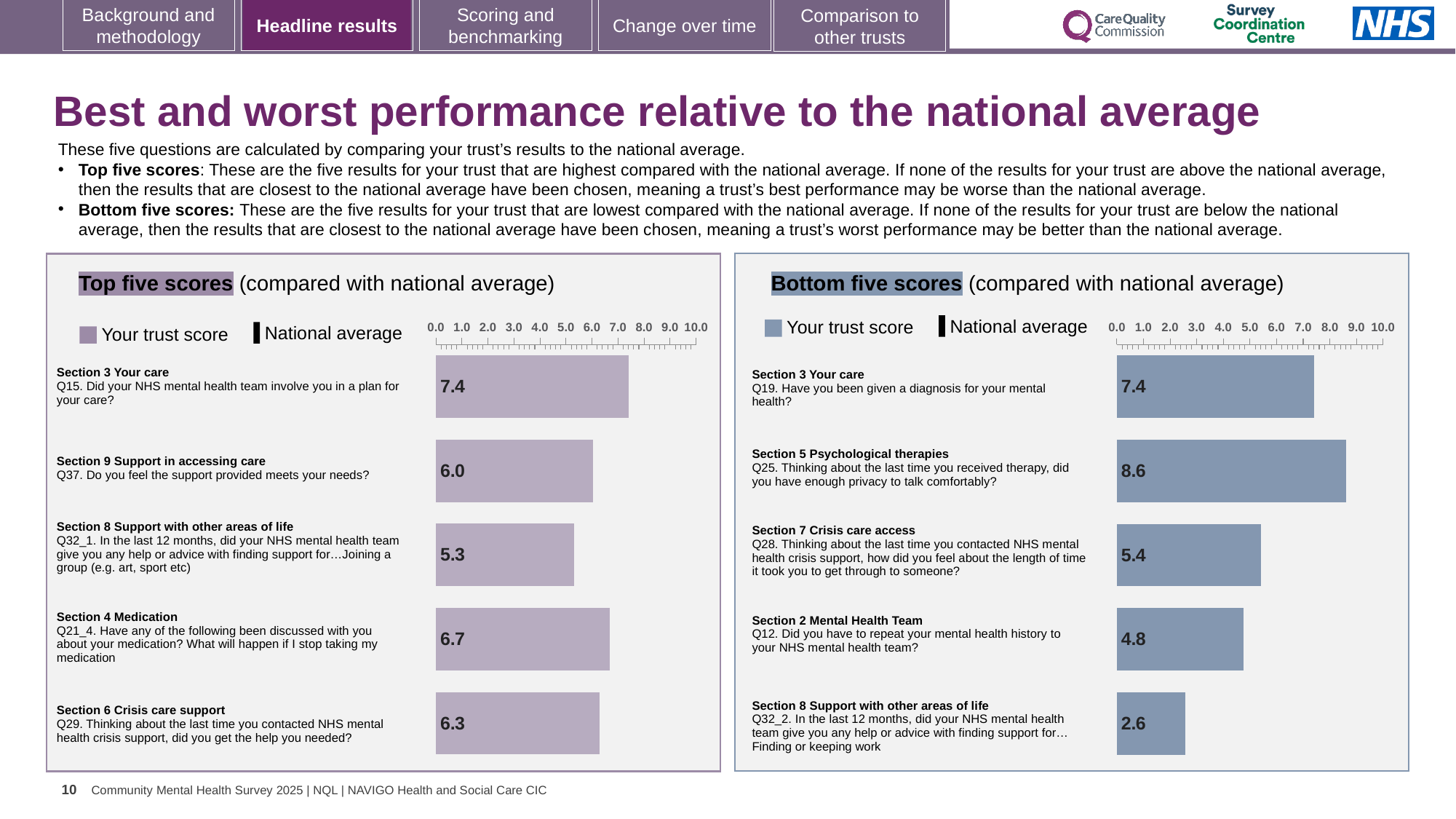
In the Top five scores chart, what is the trust score for Q37 (Do you feel the support provided meets your needs?)? 6.0 How many entries does the legend of the Bottom five scores chart list? 2 In the Bottom five scores chart, what is the trust score for Q32_2 (Finding or keeping work)? 2.6 In the Top five scores chart, what is the difference between the trust scores for Q15 and Q29? 1.1 In the Top five scores chart, how many questions are plotted? 5 In the Bottom five scores chart, what is the difference between the trust scores for Q19 and Q12? 2.6 In the Top five scores chart, what is the trust score for Q15 (Did your NHS mental health team involve you in a plan for your care?)? 7.4 What kind of chart is used in the Top five scores panel? Bar chart In the Top five scores chart, which question has the lowest trust score? Q32_1 In the Bottom five scores chart, what is the trust score for Q25 (did you have enough privacy to talk comfortably?)? 8.6 In the Bottom five scores chart, which is larger, the trust score for Q28 or for Q12? Q28 In the Bottom five scores chart, which question has the highest trust score? Q25